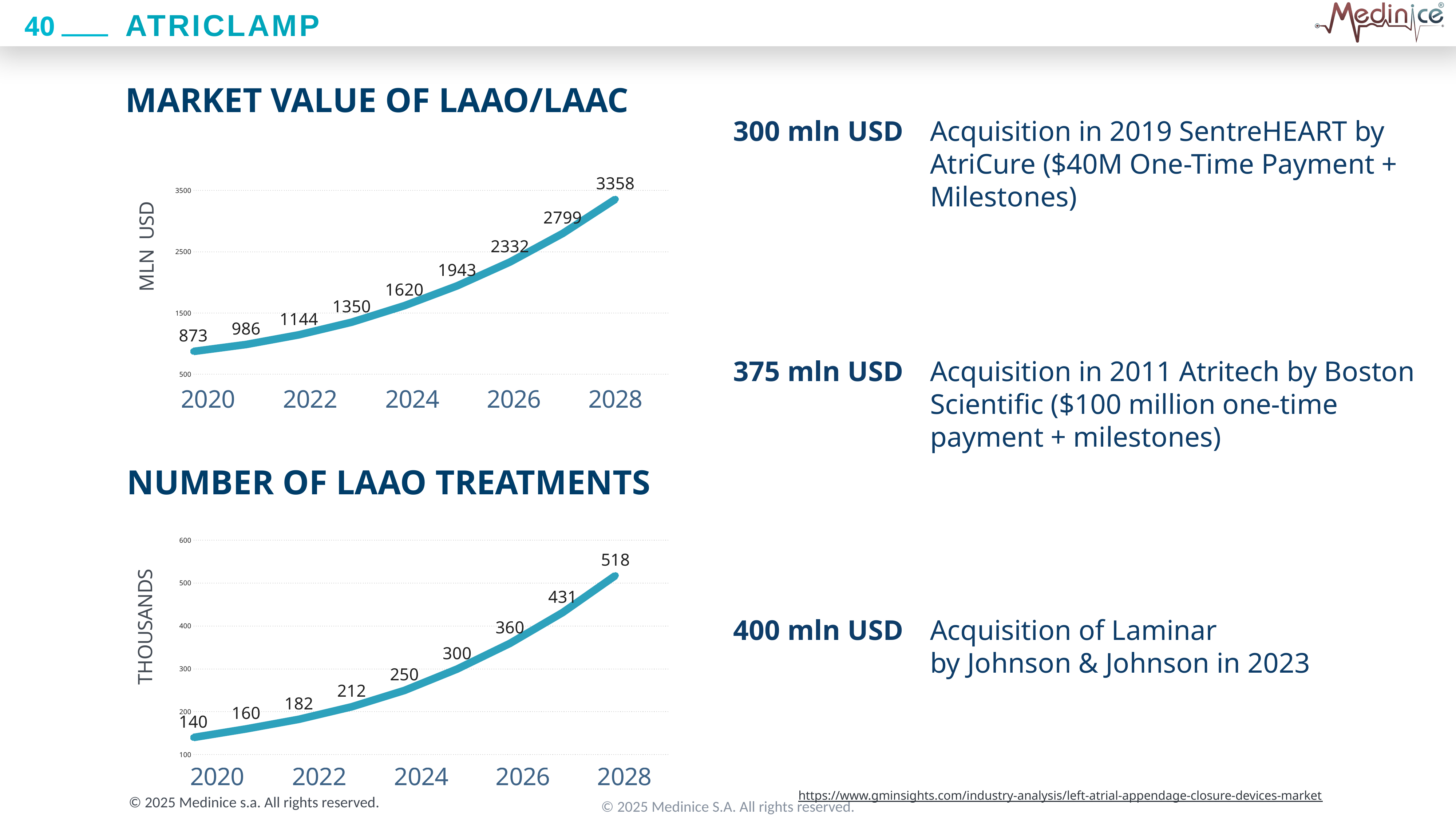
What is the y-axis label of the Number of LAAO Treatments chart? THOUSANDS In the Number of LAAO Treatments chart, what is the value for 2026? 360 In the Market Value of LAAO/LAAC chart, what is the value for 2024? 1620 In the Market Value of LAAO/LAAC chart, what is the value for 2028? 3358 In the Market Value of LAAO/LAAC chart, what is the difference between the 2028 and 2020 values? 2485 In the Market Value of LAAO/LAAC chart, how many data points are plotted? 9 In the Number of LAAO Treatments chart, do the values rise or fall from 2020 to 2028? Rise In the Market Value of LAAO/LAAC chart, what is the value for 2020? 873 In the Number of LAAO Treatments chart, which year has the lowest value? 2020 What type of chart is the Market Value of LAAO/LAAC chart? Line chart In the Number of LAAO Treatments chart, what is the value for 2020? 140 In the Market Value of LAAO/LAAC chart, which year has the highest value? 2028